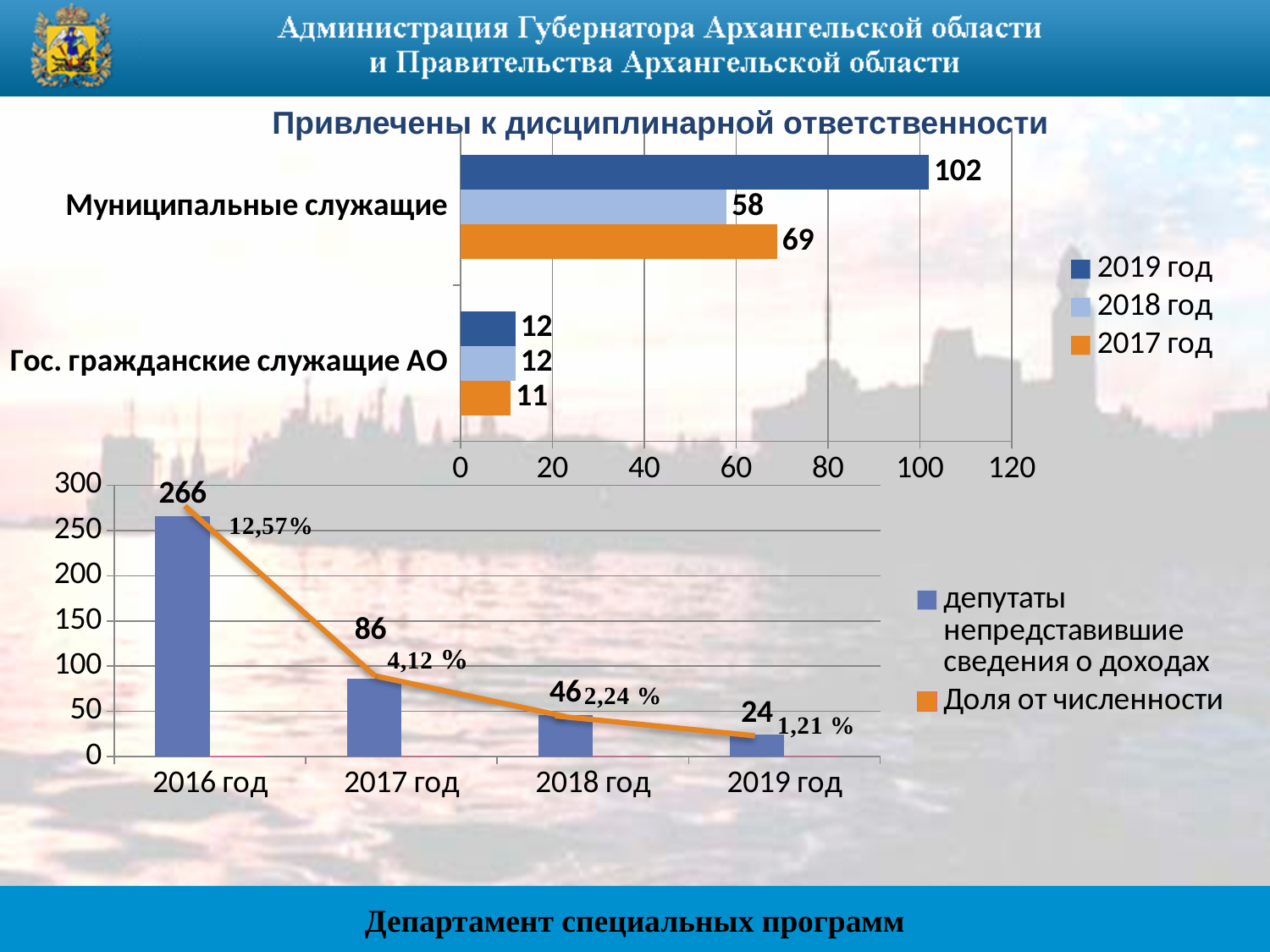
In the top chart 'Привлечены к дисциплинарной ответственности', how many series does the legend list? 3 In the bottom chart, what is the 'Доля от численности' value for 2018 год? 2,24 % In the top chart 'Привлечены к дисциплинарной ответственности', what is the value for Гос. гражданские служащие АО in 2017 год? 11 In the bottom chart, what is the difference between the 2017 год and 2018 год values of 'депутаты непредставившие сведения о доходах'? 40 In the bottom chart, do the values of 'депутаты непредставившие сведения о доходах' rise or fall from 2016 год to 2019 год? Fall In the top chart 'Привлечены к дисциплинарной ответственности', what is the difference between the 2019 год and 2017 год values for Муниципальные служащие? 33 What kind of chart is the top chart 'Привлечены к дисциплинарной ответственности'? Bar chart In the top chart 'Привлечены к дисциплинарной ответственности', what is the value for Муниципальные служащие in 2018 год? 58 In the top chart 'Привлечены к дисциплинарной ответственности', what is the value for Муниципальные служащие in 2019 год? 102 In the bottom chart, what is the value of 'депутаты непредставившие сведения о доходах' for 2016 год? 266 In the bottom chart, which year has the lowest value of 'депутаты непредставившие сведения о доходах'? 2019 год In the top chart 'Привлечены к дисциплинарной ответственности', which year has the highest value for Муниципальные служащие? 2019 год